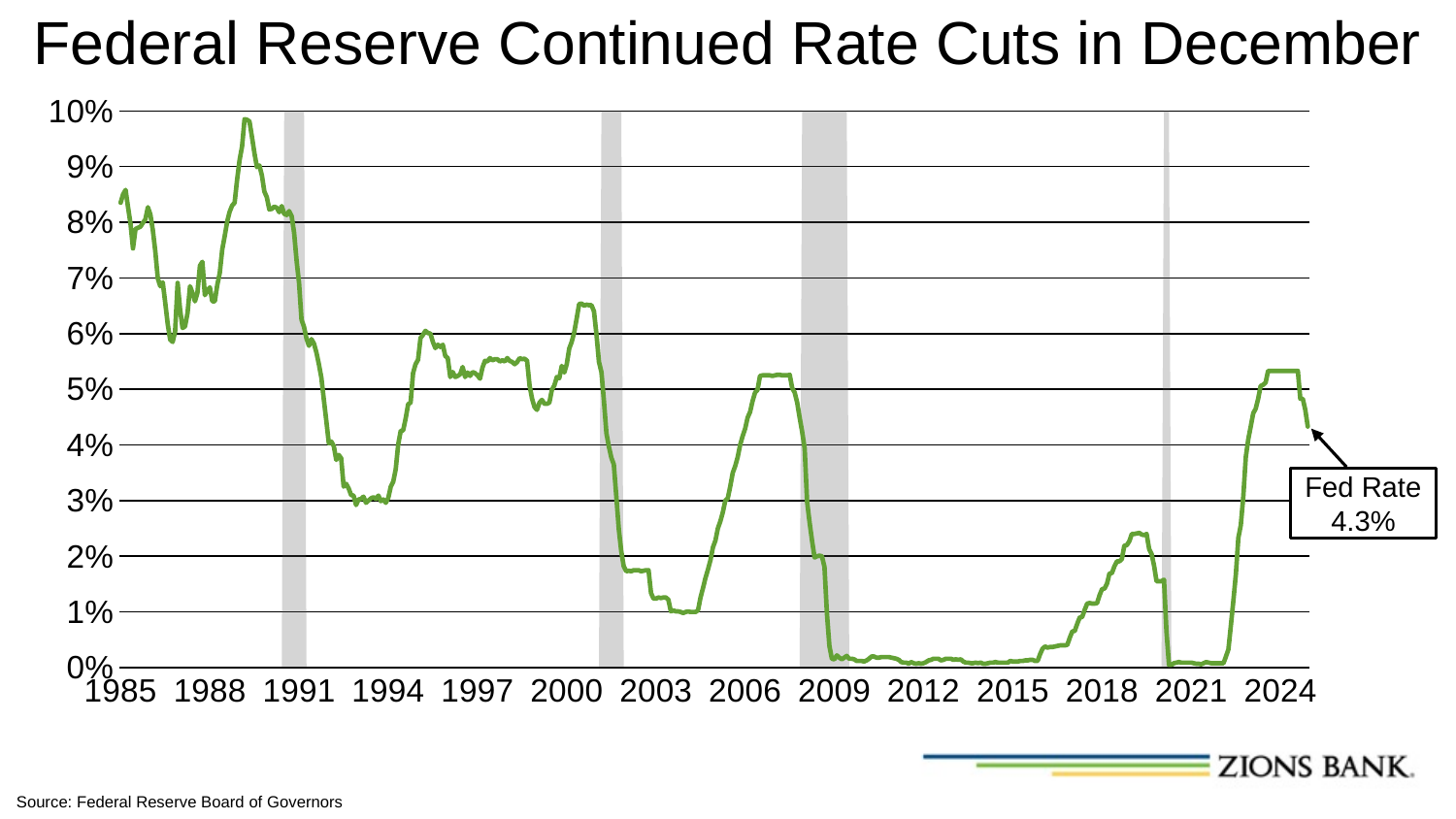
Does the Fed Rate rise or fall between 1989 and 1993? fall Is the Fed Rate in 2003 greater or less than 2%? less Is the Fed Rate at its peak around 1989 greater or less than 9%? greater Is the Fed Rate in 2012 greater or less than 1%? less What is the title of the chart? Federal Reserve Continued Rate Cuts in December Which is higher, the Fed Rate in 2019 or the Fed Rate in 2023? 2023 What is the Fed Rate value labeled at the end of the line? 4.3% Which is higher, the Fed Rate in 2000 or the Fed Rate in 2003? 2000 Does the Fed Rate rise or fall between 2022 and 2023? rise What kind of chart is shown on the slide? line chart What source is cited for the chart data? Federal Reserve Board of Governors